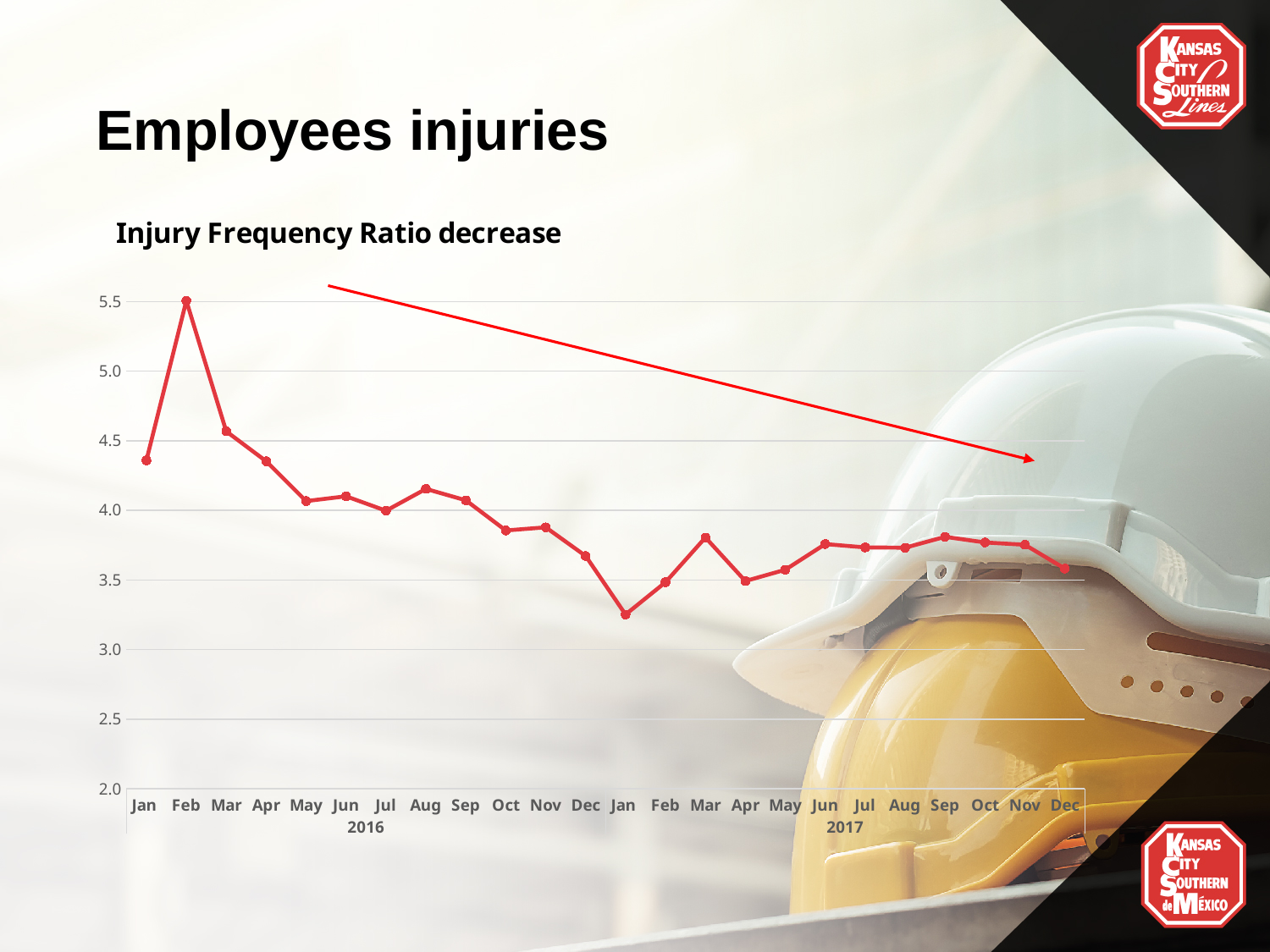
What kind of chart is shown on the slide? line chart What is the title of the chart? Injury Frequency Ratio decrease Is the value for Mar 2016 greater or less than 4.5? greater Which is larger, the value for Mar 2017 or the value for Apr 2017? Mar 2017 Which is larger, the value for Jan 2016 or the value for Dec 2017? Jan 2016 How many monthly data points are plotted on the chart? 24 Overall, do the values rise or fall from Jan 2016 to Dec 2017? fall Is the value for Jan 2017 greater or less than 3.5? less Which month has the lowest injury frequency ratio? Jan 2017 Is the value for Feb 2016 greater or less than 5.0? greater Which month has the highest injury frequency ratio? Feb 2016